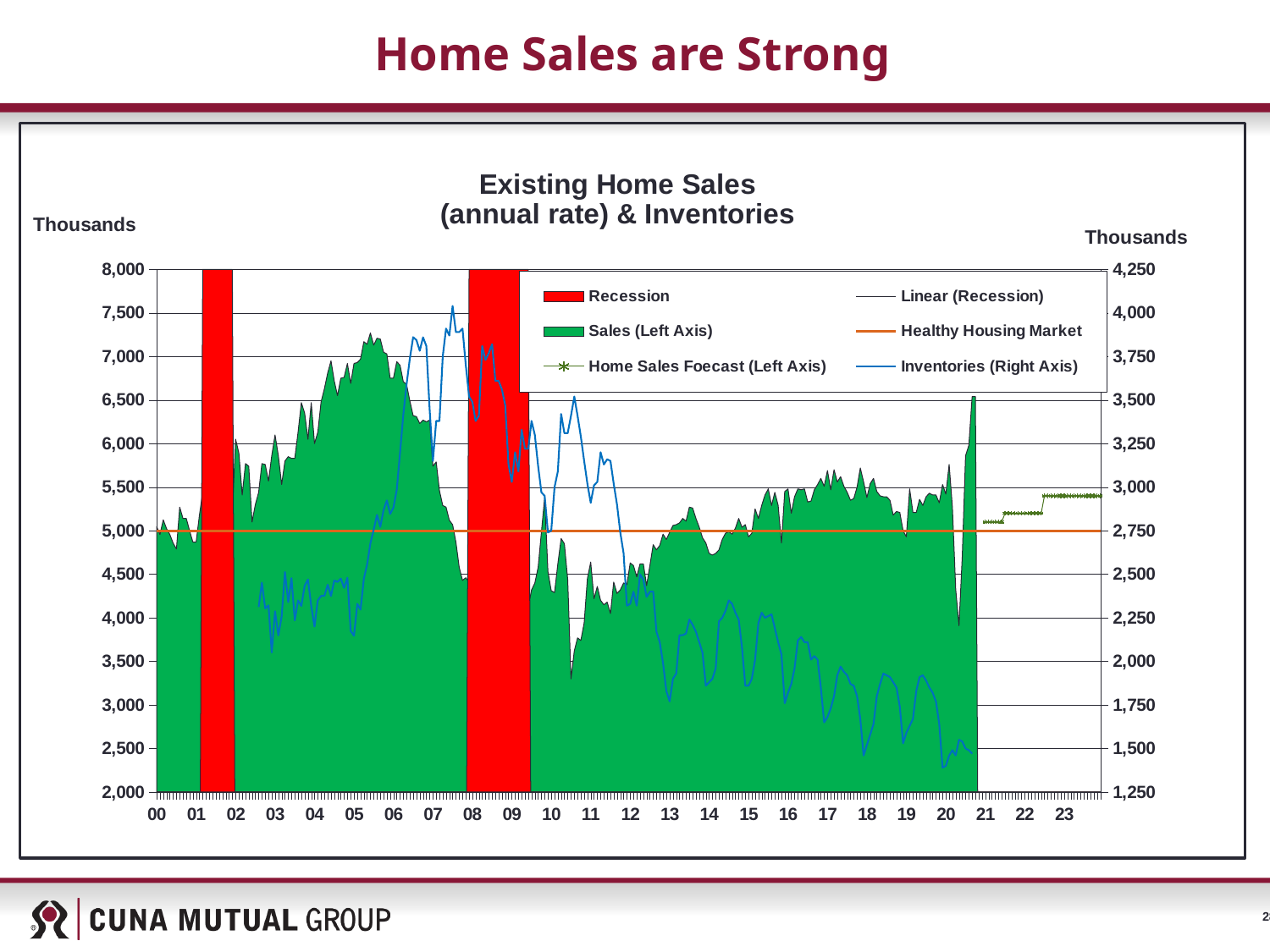
How many series does the chart's legend list? 6 Is the low point of Sales around 2010 greater or less than 3,500 on the left axis? less Do Inventories generally rise or fall from 2011 to 2020? fall What kind of chart is shown on the slide? Combined area and line chart What is the highest value shown on the right axis? 4,250 How many recession periods are shaded on the chart? 2 At what value on the left axis does the Healthy Housing Market line sit? 5,000 Is the peak of Sales around 2005 greater or less than 7,000 on the left axis? greater What is the title of the chart? Existing Home Sales (annual rate) & Inventories Is the Inventories value at the end of 2020 greater or less than 1,750 on the right axis? less Which is larger, Sales at the 2005 peak or Sales at the 2010 low? Sales at the 2005 peak